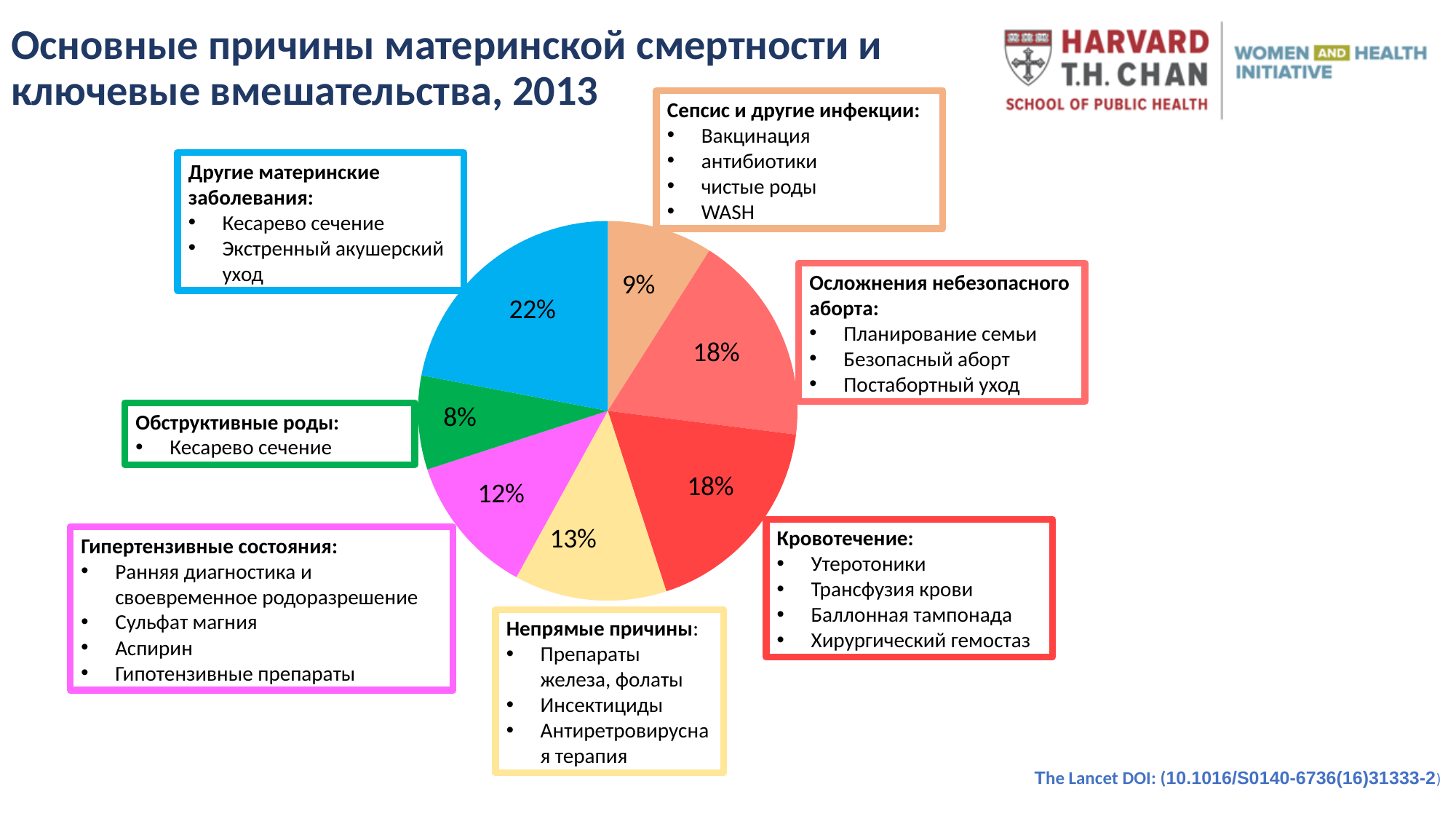
What is the difference between the share for Другие материнские заболевания and the share for Кровотечение? 4% Which is larger: the share for Непрямые причины or the share for Гипертензивные состояния? Непрямые причины What share of the pie is labelled for Обструктивные роды (green slice)? 8% What share of the pie is labelled for Сепсис и другие инфекции (orange slice)? 9% Which cause has the smallest slice of the pie? Обструктивные роды How many slices does the pie chart have? 7 What share of the pie is labelled for Гипертензивные состояния (magenta slice)? 12% What share of the pie is labelled for Непрямые причины (yellow slice)? 13% What share of the pie is labelled for Другие материнские заболевания (blue slice)? 22% What year is given in the chart's title? 2013 Which cause has the largest slice of the pie? Другие материнские заболевания What kind of chart is shown on the slide? pie chart